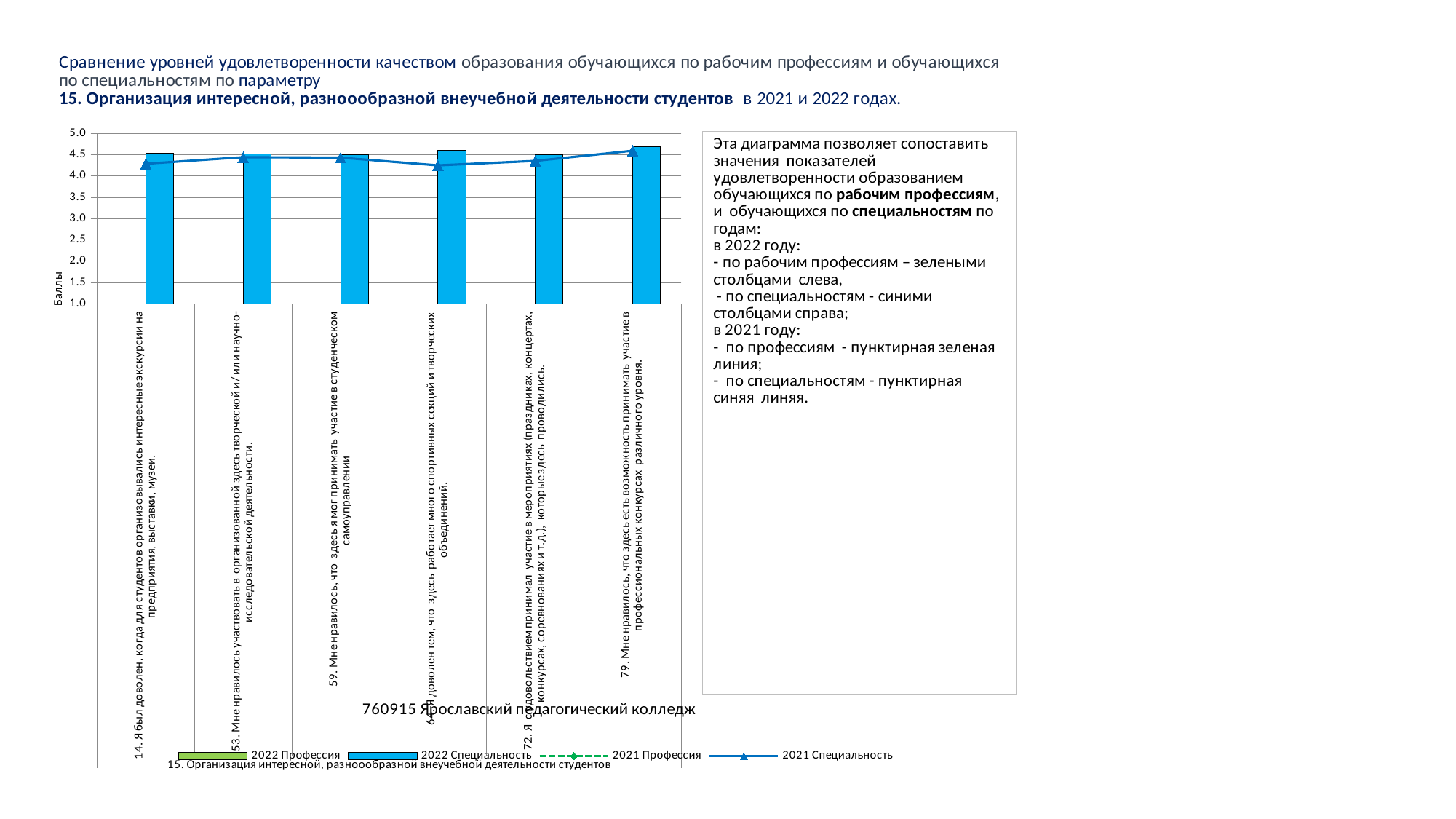
Is the 2021 Специальность line point for category 79 greater or less than 4.0? greater Is the 2021 Специальность line point for category 64 greater or less than 4.5? less Which is larger: the 2022 Специальность bar for category 79 or for category 59? category 79 Which category has the highest 2021 Специальность line point? 79 How many categories (questions) are plotted along the x axis of the chart? 6 Is the 2022 Специальность bar for category 64 greater or less than 4.5? greater How many series does the chart legend list? 4 What is the maximum value shown on the vertical axis of the chart? 5.0 What is the label of the vertical axis of the chart? Баллы What kind of chart is shown on the slide? bar chart with a line